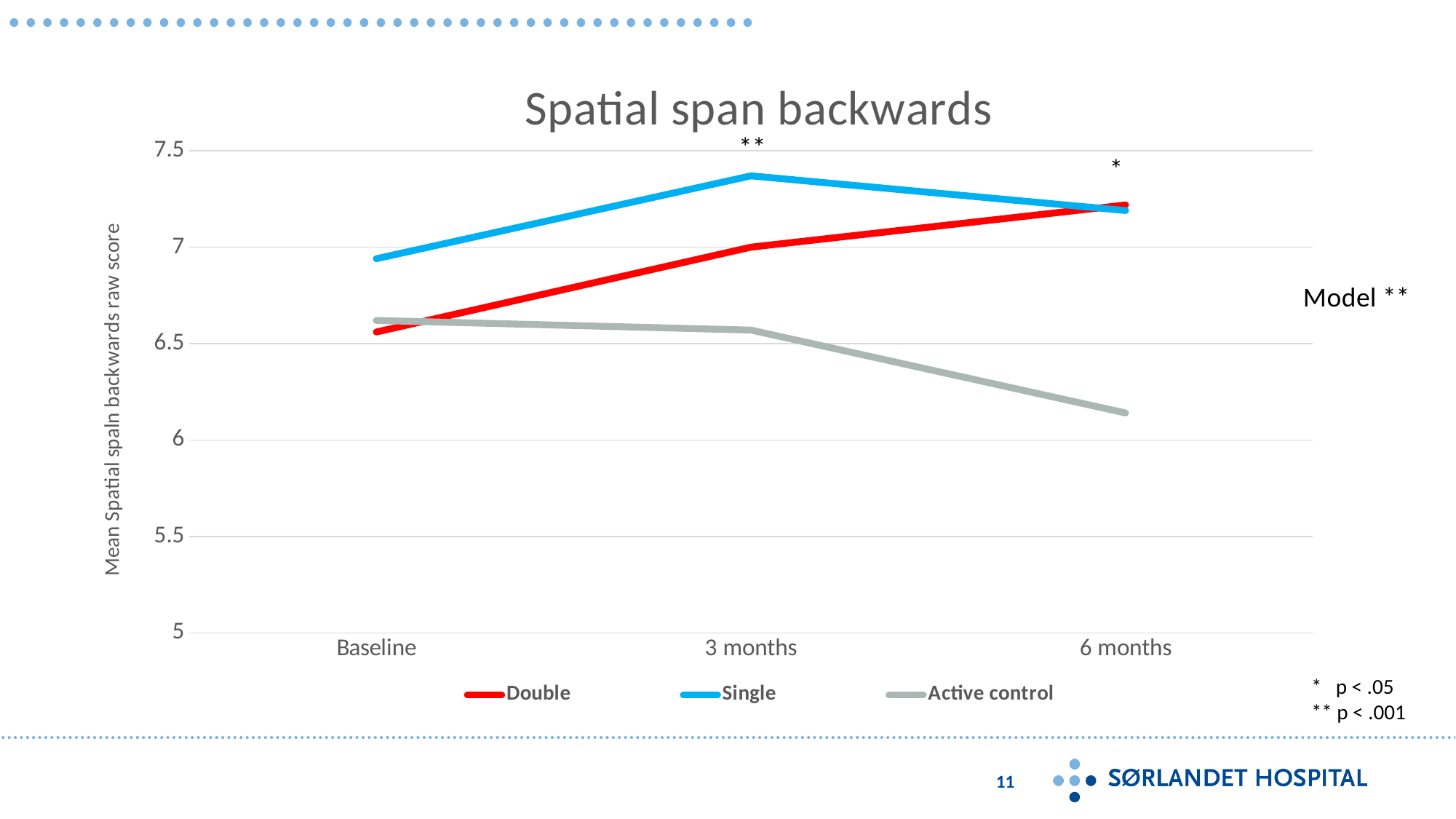
Is the value for Double at 6 months greater or less than 7? greater How many time points are shown on the x axis? 3 What is the title of the chart? Spatial span backwards Does the Active control line rise or fall from Baseline to 6 months? fall What kind of chart is shown on the slide? line chart Is the value for Single at 3 months greater or less than 7? greater At 3 months, which series has the higher value, Single or Double? Single Is the value for Single at Baseline greater or less than 6.5? greater At 6 months, which series has the higher value, Double or Active control? Double Which series has the lowest value at 6 months? Active control How many series does the legend list? 3